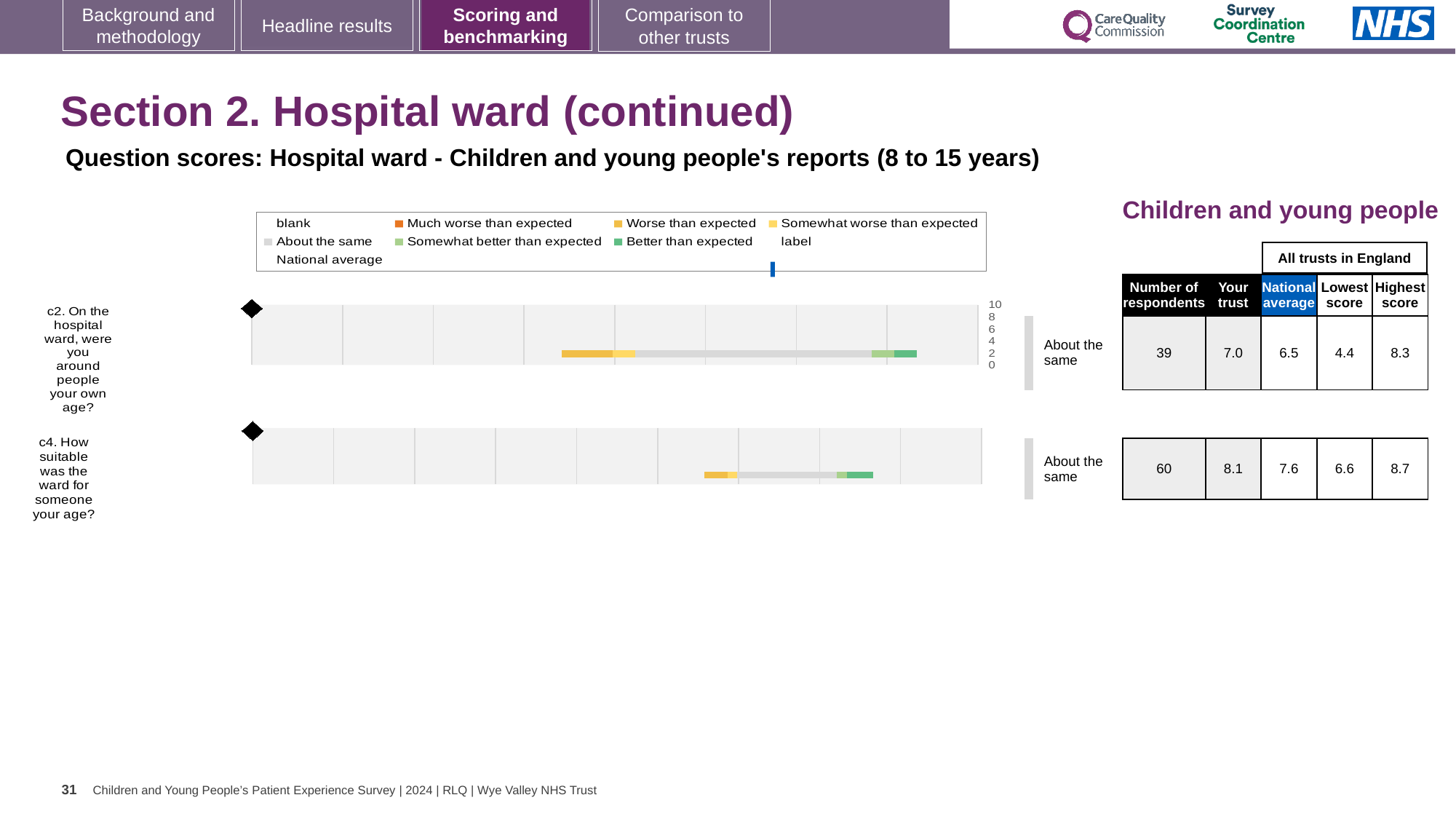
For the c2 chart, how many respondents are there? 39 For the c2 chart, what is the difference between the highest score and the lowest score across all trusts in England? 3.9 What is the maximum value shown on the score axis of the c2 chart? 10 For the c4 chart, what is the lowest score among all trusts in England? 6.6 What benchmark category is shown next to the c2 chart? About the same For the c4 chart (how suitable was the ward for someone your age?), what is the national average score? 7.6 For the c2 chart (were you around people your own age?), what is the 'Your trust' score? 7.0 For the c2 chart, is the 'Your trust' score greater or less than the national average? greater Which question has the higher 'Your trust' score, c2 or c4? c4 What kind of chart is used to show the question scores for c2 and c4? bar chart How many questions (bars) are plotted on the slide? 2 For the c4 chart, what is the difference between the 'Your trust' score and the national average? 0.5